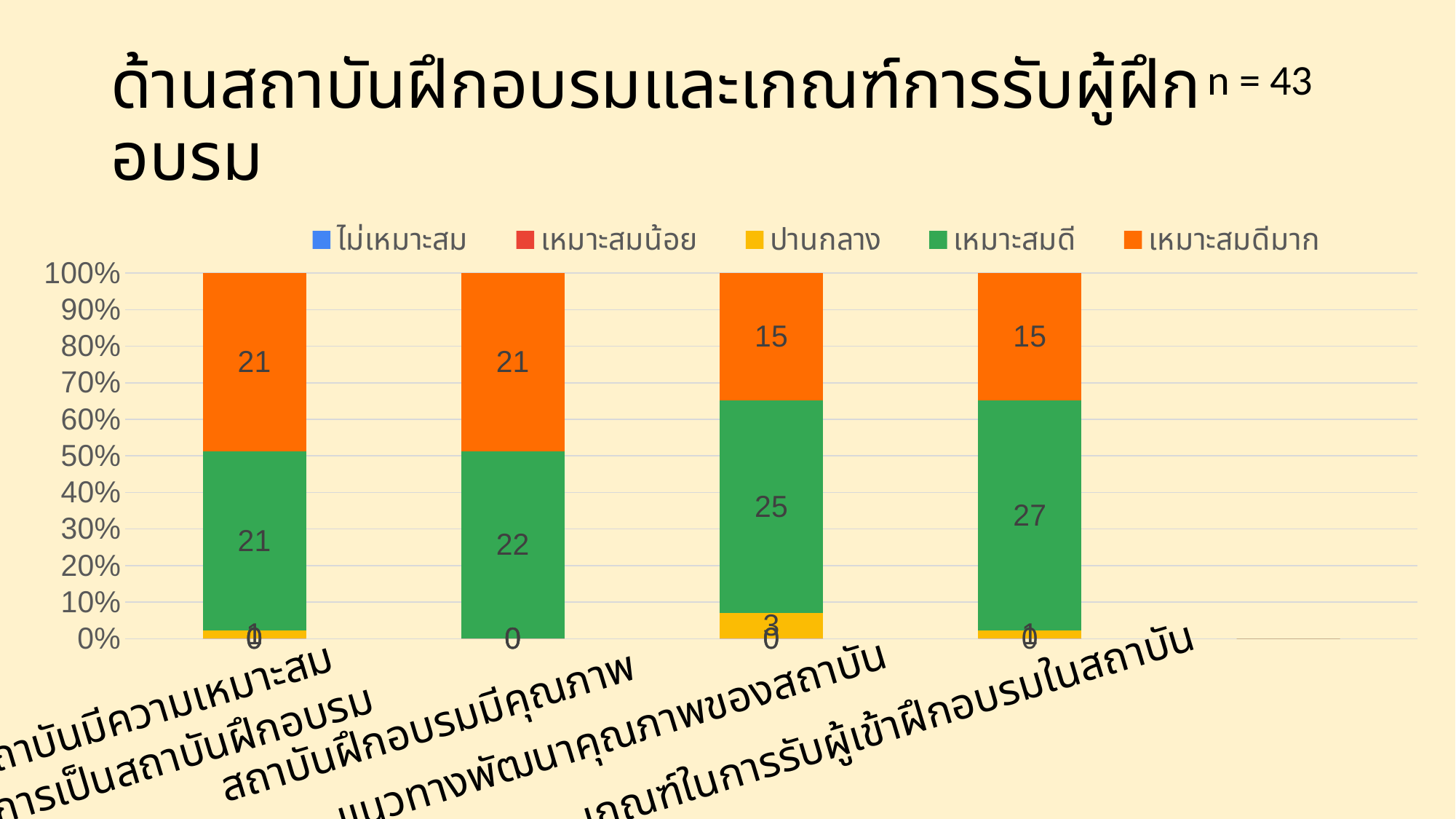
For the category สถาบันฝึกอบรมมีคุณภาพ, which is larger: เหมาะสมดี or เหมาะสมดีมาก? เหมาะสมดี What is the value of เหมาะสมดีมาก for the third bar from the left? 15 What kind of chart is shown on the slide? stacked bar chart For the fourth (rightmost) bar, what is the difference between เหมาะสมดี and เหมาะสมดีมาก? 12 What is the value of เหมาะสมดี for the category สถาบันฝึกอบรมมีคุณภาพ? 22 What is the value of เหมาะสมดีมาก for the category สถาบันฝึกอบรมมีคุณภาพ? 21 What sample size (n) is shown on the slide? n = 43 What is the value of ปานกลาง for the third bar from the left? 3 What is the value of เหมาะสมดี for the fourth (rightmost) bar? 27 How many series does the legend list? 5 How many categories (bars) are plotted in the chart? 4 Which bar has the highest value for เหมาะสมดี? the fourth (rightmost) bar